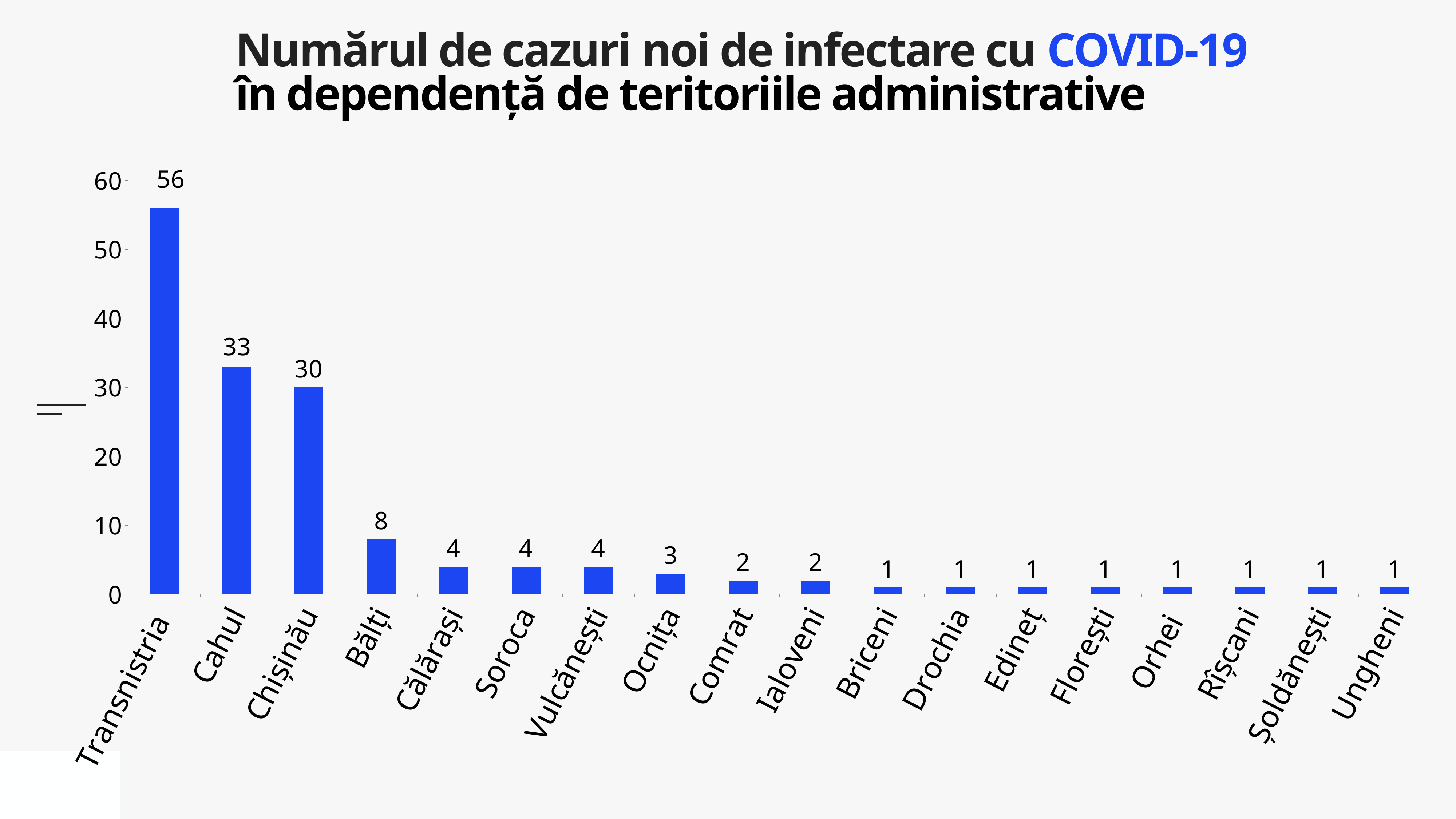
Is the value for Cahul greater or less than 40? less What kind of chart is shown on the slide? bar chart What is the value for Transnistria? 56 Which is larger, the value for Bălți or the value for Călărași? Bălți What is the value for Chișinău? 30 Do the values rise or fall from left to right along the x axis? fall What is the value for Ocnița? 3 What is the difference between the values for Cahul and Chișinău? 3 Which territory has the highest number of new cases? Transnistria What is the difference between the values for Transnistria and Cahul? 23 How many territories are shown on the x axis? 18 What is the value for Bălți? 8